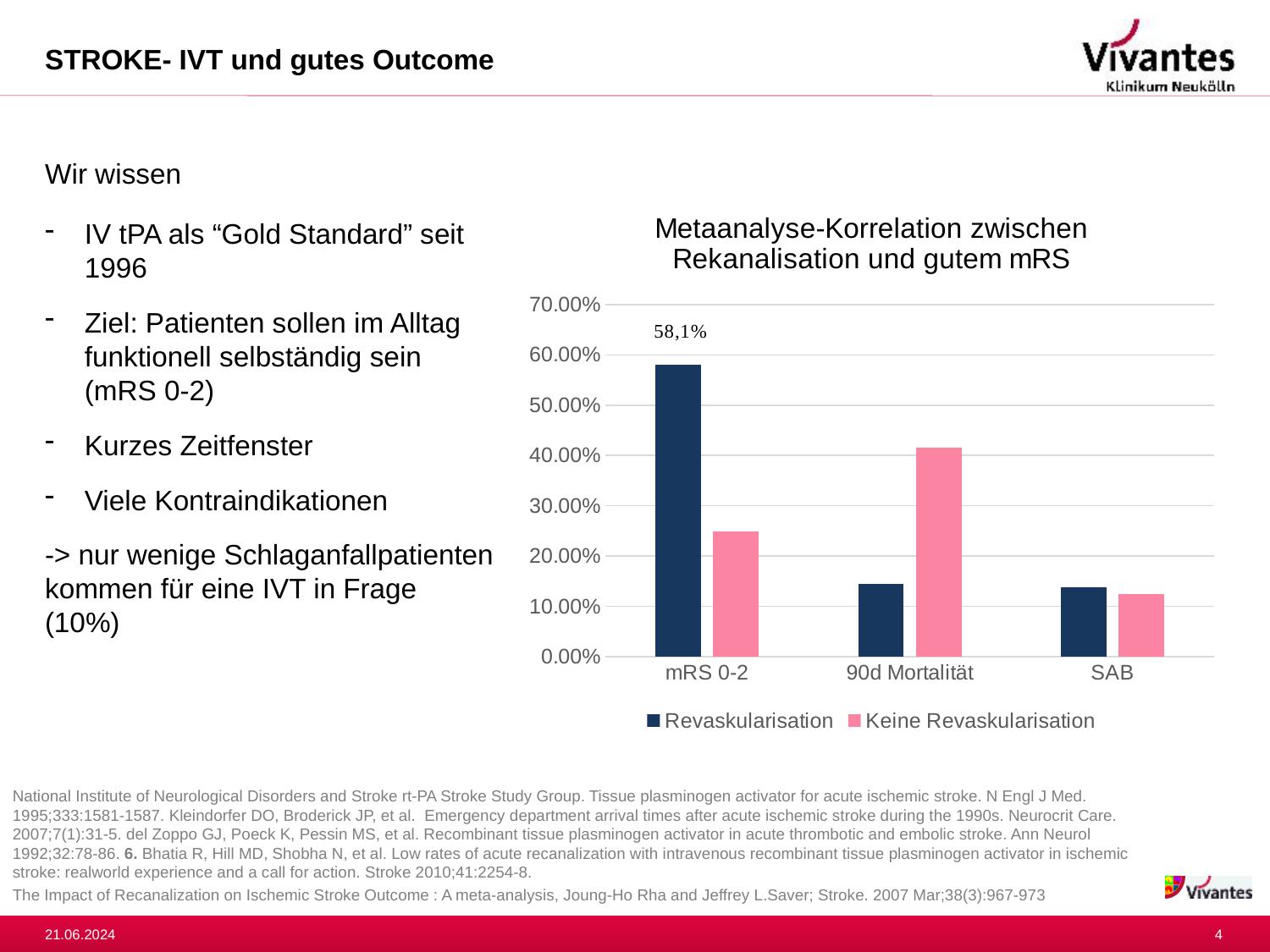
In the mRS 0-2 category, which series has the larger value, Revaskularisation or Keine Revaskularisation? Revaskularisation In which category is the Revaskularisation bar the highest? mRS 0-2 Is the value for Keine Revaskularisation in the 90d Mortalität category greater or less than 30.00%? greater How many series does the chart legend list? 2 Is the value for Revaskularisation in the 90d Mortalität category greater or less than 20.00%? less What kind of chart is shown on the slide? Bar chart What is the title of the chart? Metaanalyse-Korrelation zwischen Rekanalisation und gutem mRS How many categories are shown on the x axis of the chart? 3 In which category is the Keine Revaskularisation bar the lowest? SAB What is the value for Revaskularisation in the mRS 0-2 category? 58,1% In the 90d Mortalität category, which series has the larger value, Revaskularisation or Keine Revaskularisation? Keine Revaskularisation Is the value for Keine Revaskularisation in the mRS 0-2 category greater or less than 30.00%? less